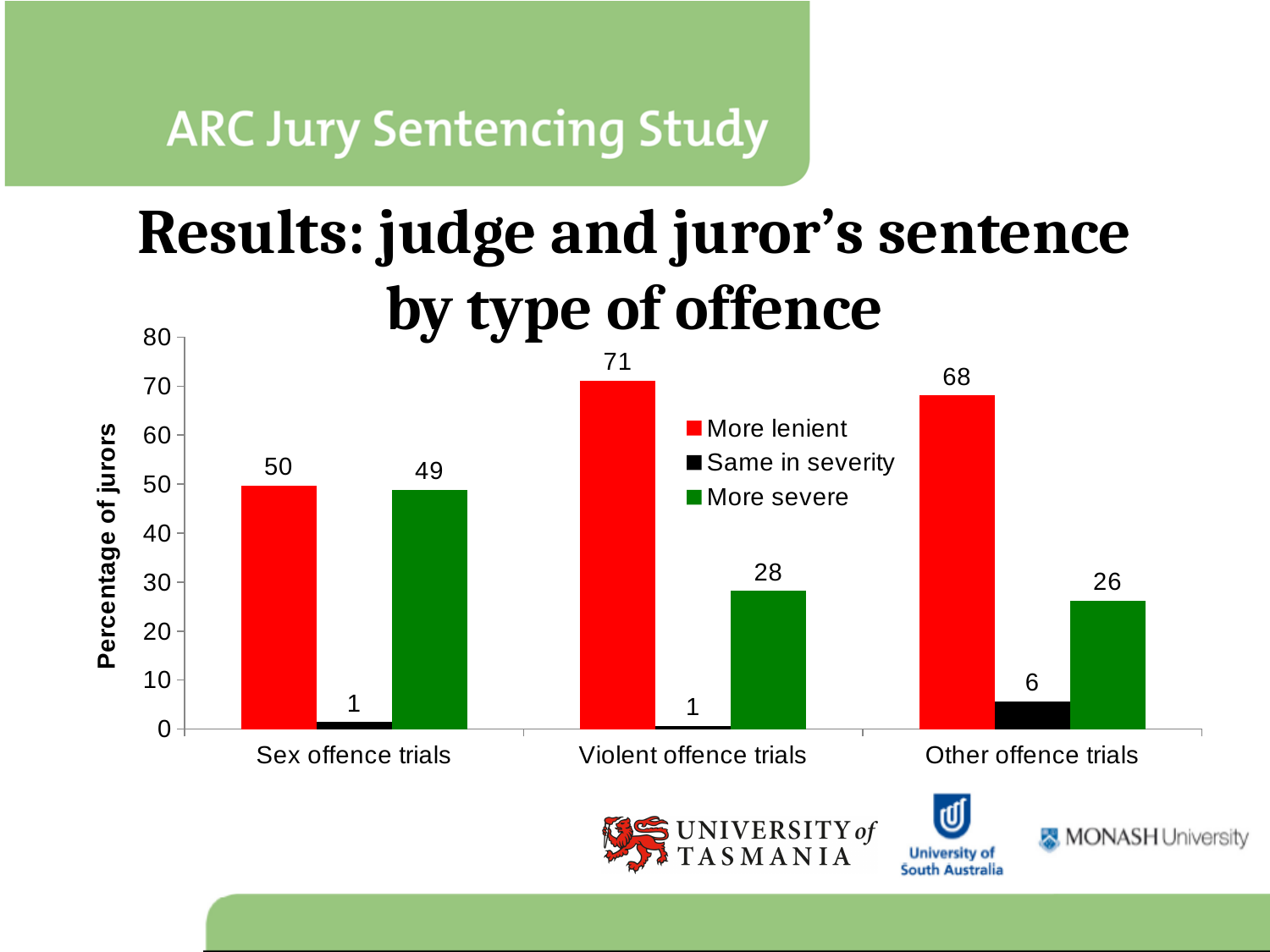
How many types of trial are shown on the x axis? 3 How many series does the legend list? 3 Which type of trial has the highest percentage of jurors who were more lenient? Violent offence trials Which colour represents the 'Same in severity' series? Black What kind of chart is shown on the slide? Bar chart What percentage of jurors were more lenient in violent offence trials? 71 What percentage of jurors were more severe in sex offence trials? 49 What percentage of jurors were the same in severity in other offence trials? 6 What is the difference between the more lenient and more severe percentages in other offence trials? 42 Is the more severe percentage higher in violent offence trials or in other offence trials? Violent offence trials Which type of trial has the lowest percentage of jurors who were more severe? Other offence trials What is the label of the y axis? Percentage of jurors